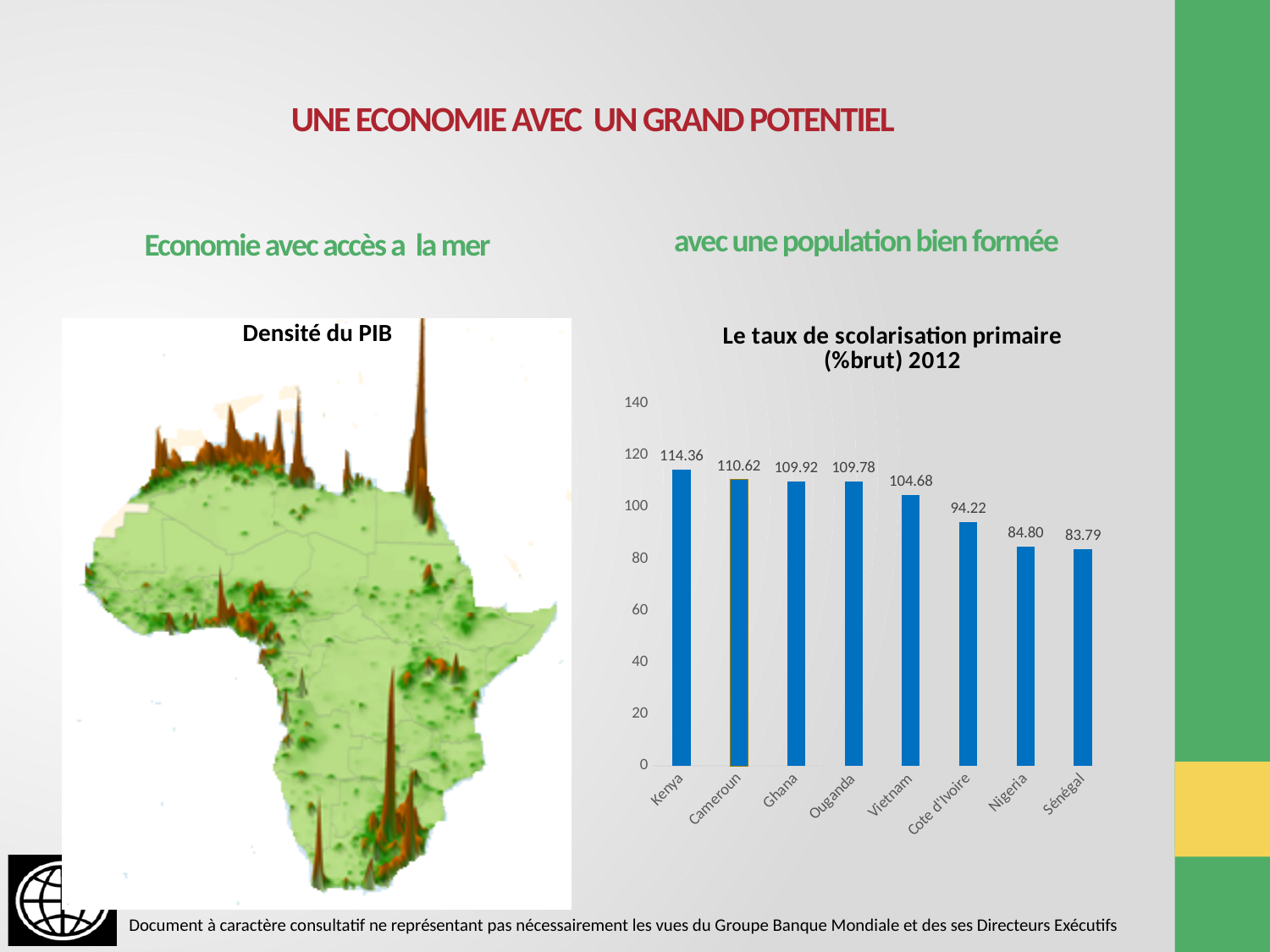
What is the value for Cameroun in the chart 'Le taux de scolarisation primaire (%brut) 2012'? 110.62 Which country has the highest value in the chart 'Le taux de scolarisation primaire (%brut) 2012'? Kenya In the chart 'Le taux de scolarisation primaire (%brut) 2012', do the values rise or fall from left to right? fall In the chart 'Le taux de scolarisation primaire (%brut) 2012', which is larger, the value for Vietnam or the value for Nigeria? Vietnam Which country has the lowest value in the chart 'Le taux de scolarisation primaire (%brut) 2012'? Sénégal What is the value for Kenya in the chart 'Le taux de scolarisation primaire (%brut) 2012'? 114.36 How many countries are shown in the chart 'Le taux de scolarisation primaire (%brut) 2012'? 8 In the chart 'Le taux de scolarisation primaire (%brut) 2012', what is the difference between the values for Kenya and Sénégal? 30.57 In the chart 'Le taux de scolarisation primaire (%brut) 2012', is the value for Nigeria greater or less than 100? less What kind of chart is 'Le taux de scolarisation primaire (%brut) 2012'? bar chart What is the value for Cote d'Ivoire in the chart 'Le taux de scolarisation primaire (%brut) 2012'? 94.22 In the chart 'Le taux de scolarisation primaire (%brut) 2012', what is the difference between the values for Vietnam and Cote d'Ivoire? 10.46